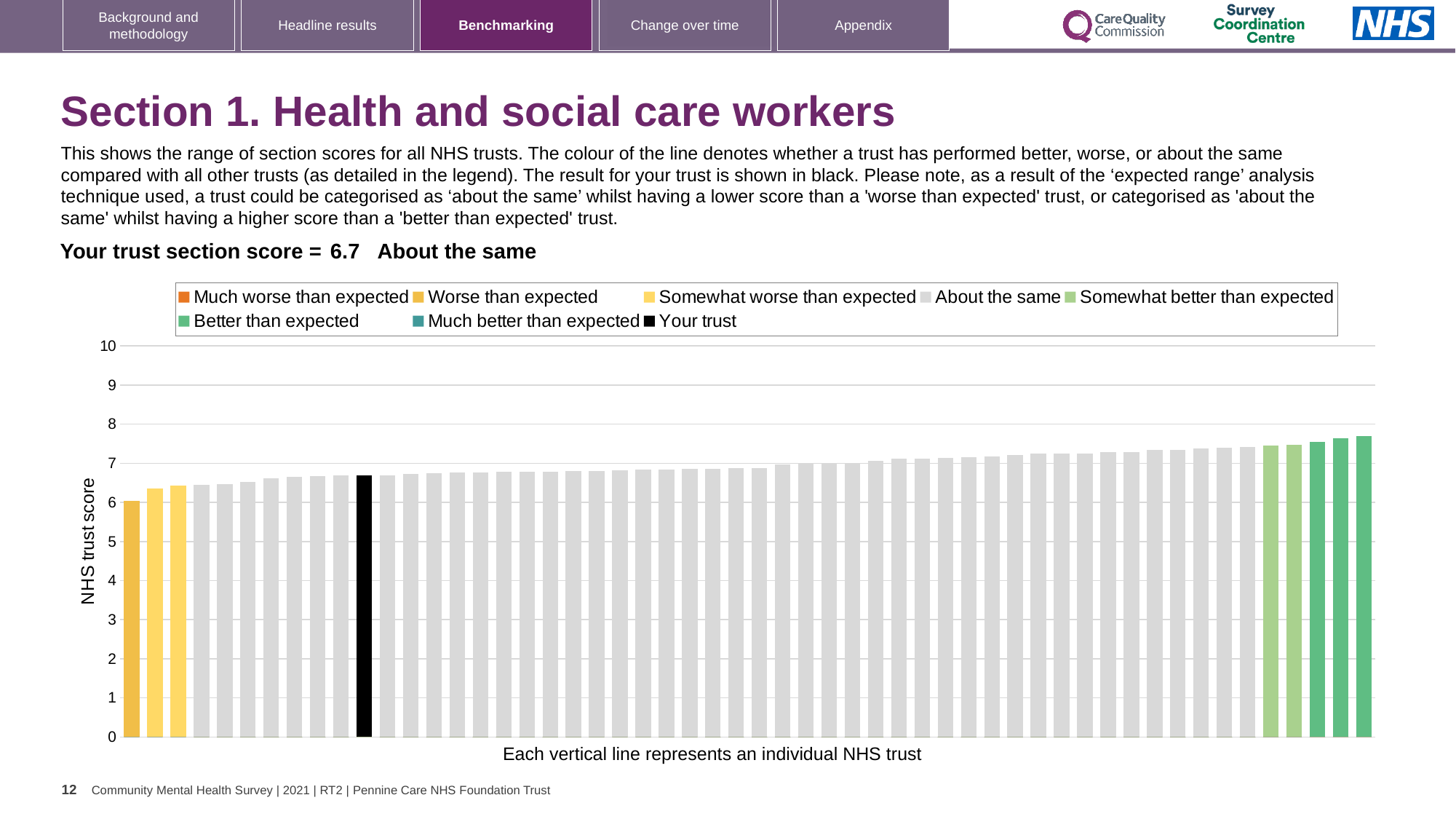
What type of chart is shown on the slide? Bar chart Is the value of the leftmost (lowest) bar greater or less than 5? greater What colour is the bar representing your trust? Black What is the label on the vertical axis of the chart? NHS trust score Which performance category is your trust placed in for this section? About the same Is the value of the tallest bar in the chart greater or less than 8? less How many entries does the chart legend list? 8 Is the value of the black bar (your trust) greater or less than 5? greater What is the section score for your trust shown on the slide? 6.7 How many bars are coloured as 'Better than expected' (dark green)? 3 How many bars are coloured as 'Somewhat worse than expected' (yellow)? 2 Do the bar values rise or fall moving from left to right along the x axis? Rise